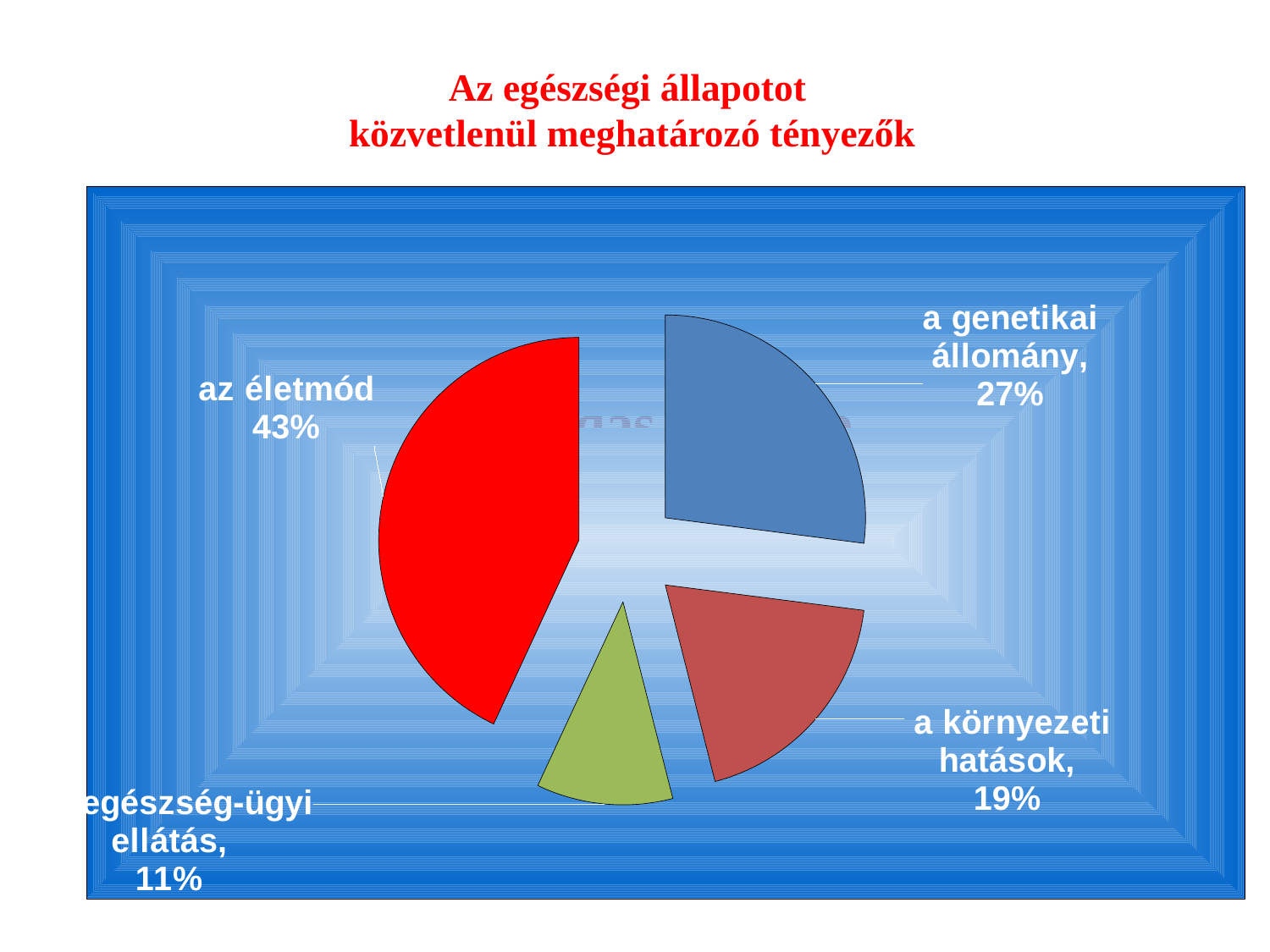
What share of the pie does "a genetikai állomány" represent? 27% What share of the pie does "egészség-ügyi ellátás" represent? 11% What is the title of the slide containing the pie chart? Az egészségi állapotot közvetlenül meghatározó tényezők What colour is the slice for "az életmód"? red What is the difference in percentage points between "az életmód" and "a genetikai állomány"? 16 How many slices does the pie chart have? 4 Which is larger, the share for "a környezeti hatások" or the share for "egészség-ügyi ellátás"? a környezeti hatások Which slice of the pie is the smallest? egészség-ügyi ellátás What kind of chart is shown on the slide? pie chart What share of the pie does "a környezeti hatások" represent? 19% What share of the pie does "az életmód" represent? 43% Which slice of the pie is the largest? az életmód